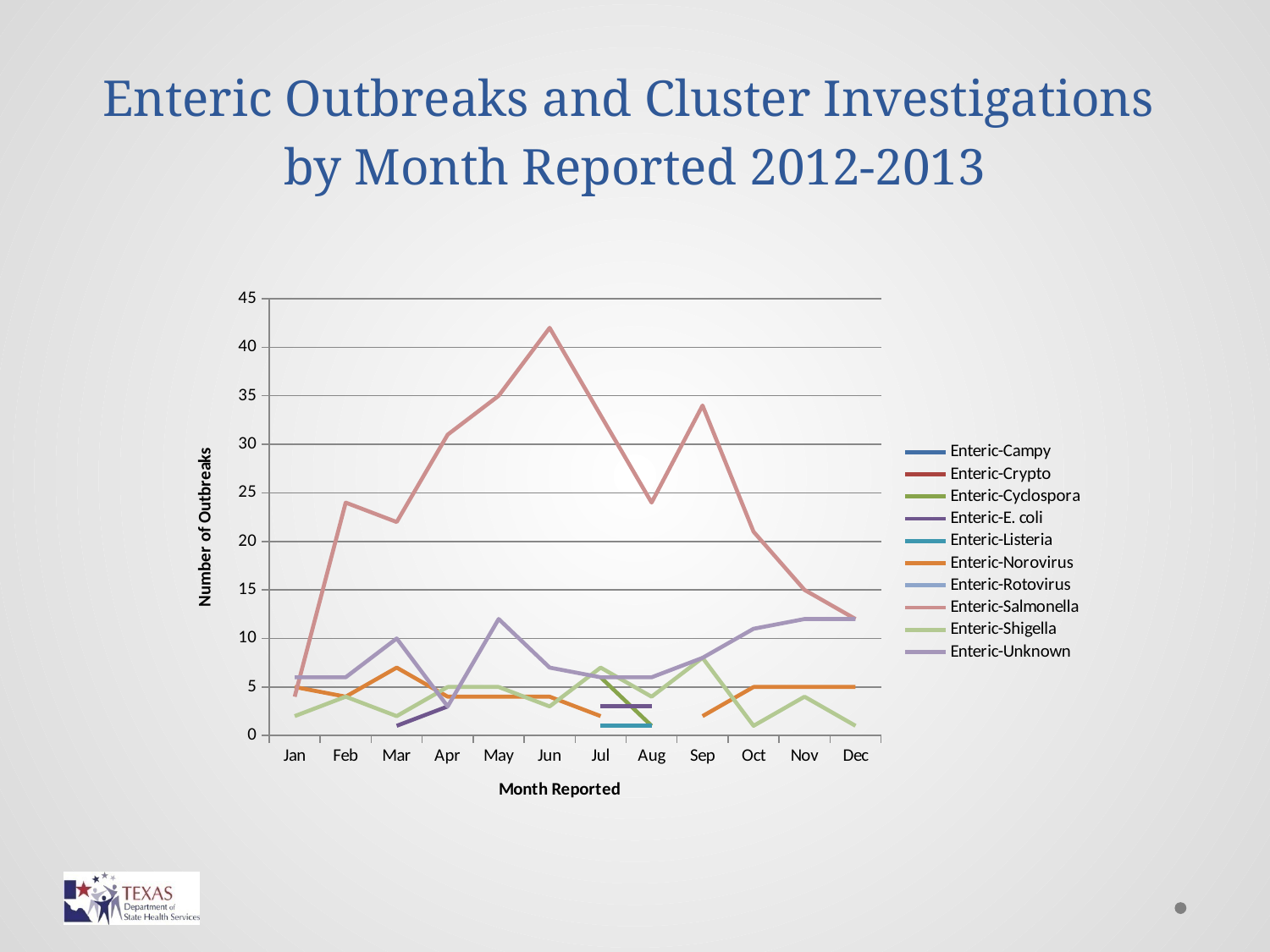
Is the value for Enteric-Salmonella in Feb greater or less than 20? greater In which month does Enteric-Salmonella reach its highest value? Jun Is the value for Enteric-Unknown in Dec greater or less than 10? greater In which month is the Enteric-Salmonella value lowest? Jan How many months are shown on the x axis? 12 What kind of chart is shown on the slide? line chart Does the Enteric-Salmonella line rise or fall from Sep to Dec? fall What is the title of the x axis? Month Reported How many series does the legend list? 10 Is the value for Enteric-Salmonella in Jun greater or less than 40? greater Which series has the larger value in Jun, Enteric-Salmonella or Enteric-Unknown? Enteric-Salmonella